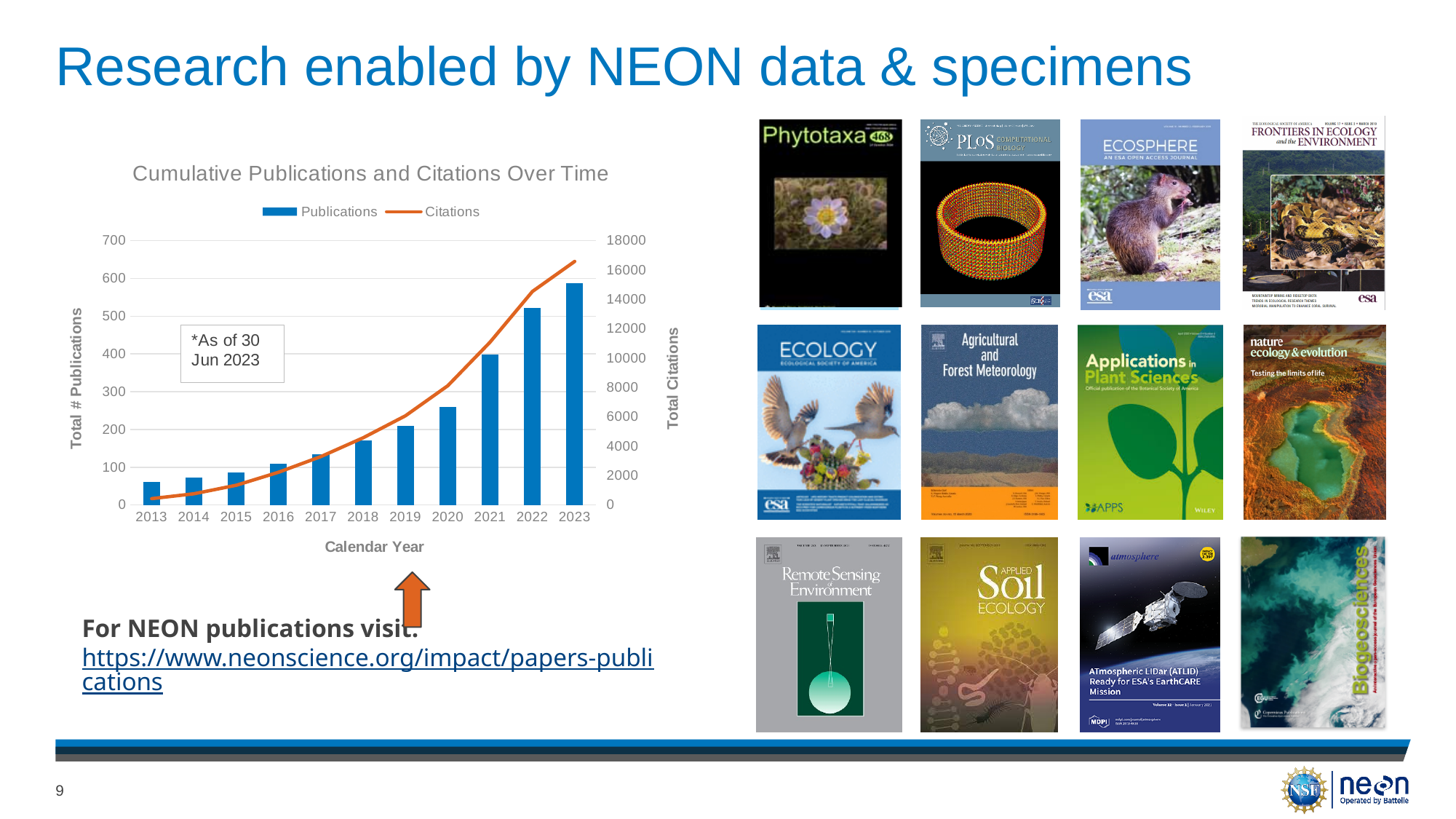
What is the label of the left vertical axis of the chart? Total # Publications Is the number of publications for 2013 greater or less than 100? less Do the citations rise or fall from 2013 to 2023 in the chart? rise How many calendar years are shown on the x axis of the chart? 11 How many series does the chart legend list? 2 What is the title of the chart on the slide? Cumulative Publications and Citations Over Time Which year has the lowest number of publications in the chart? 2013 Is the number of publications for 2023 greater or less than 500? greater Which year has the highest number of publications in the chart? 2023 Is the total citations value for 2023 greater or less than 14000? greater Which year has more publications, 2022 or 2021? 2022